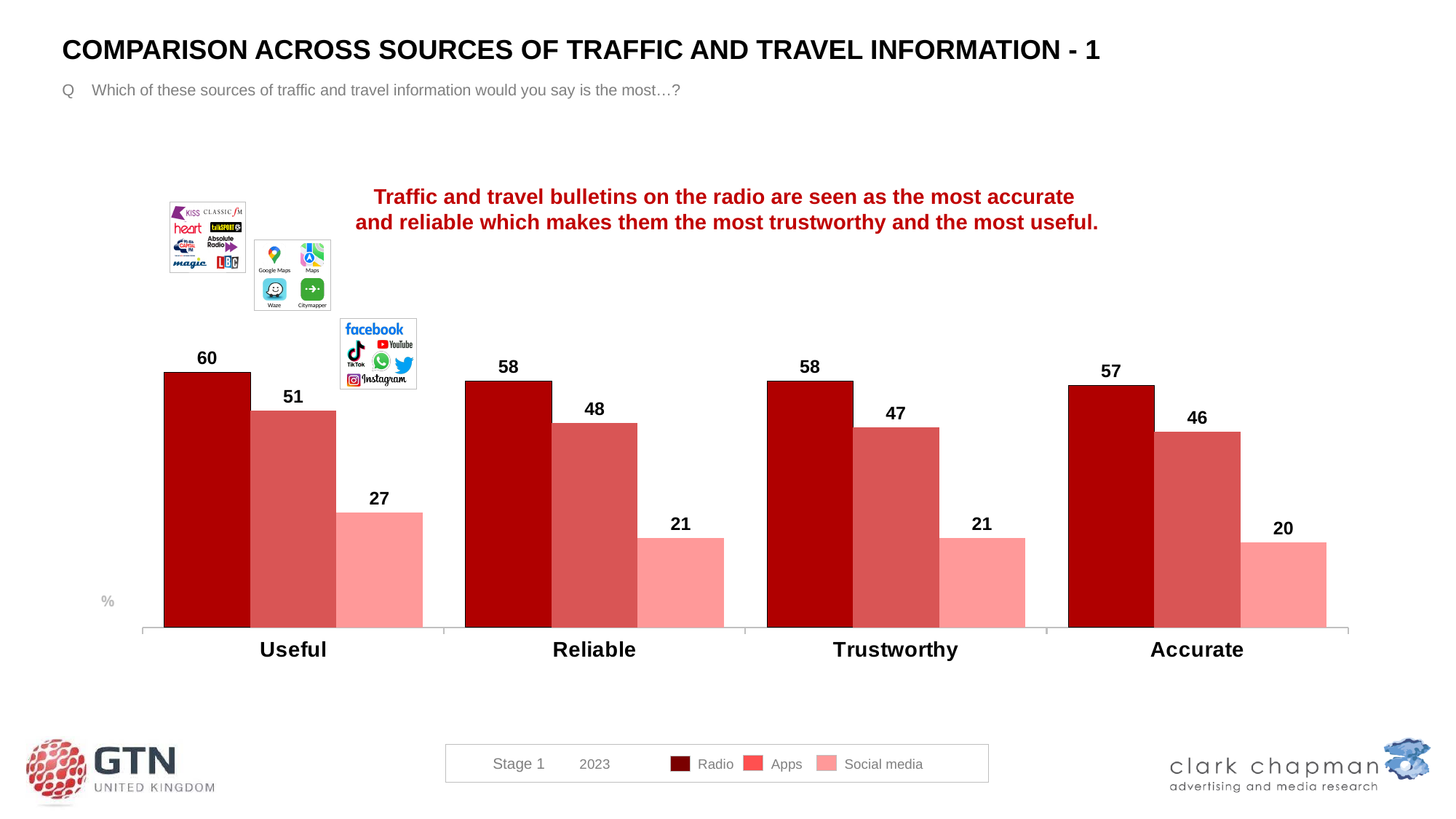
How many series does the legend list? 3 What is the value for Social media in the Accurate category? 20 What is the difference between the Radio and Apps values in the Accurate category? 11 Which is larger: the Social media value for Useful or the Social media value for Reliable? Useful How many categories are shown on the x axis? 4 What is the value for Radio in the Useful category? 60 What is the value for Apps in the Reliable category? 48 Which series has the lowest value in the Useful category? Social media Do the Radio values rise or fall from Useful to Accurate along the x axis? Fall Which series is shown in the darkest red colour? Radio What kind of chart is shown on the slide? Bar chart Which series has the highest value in the Trustworthy category? Radio